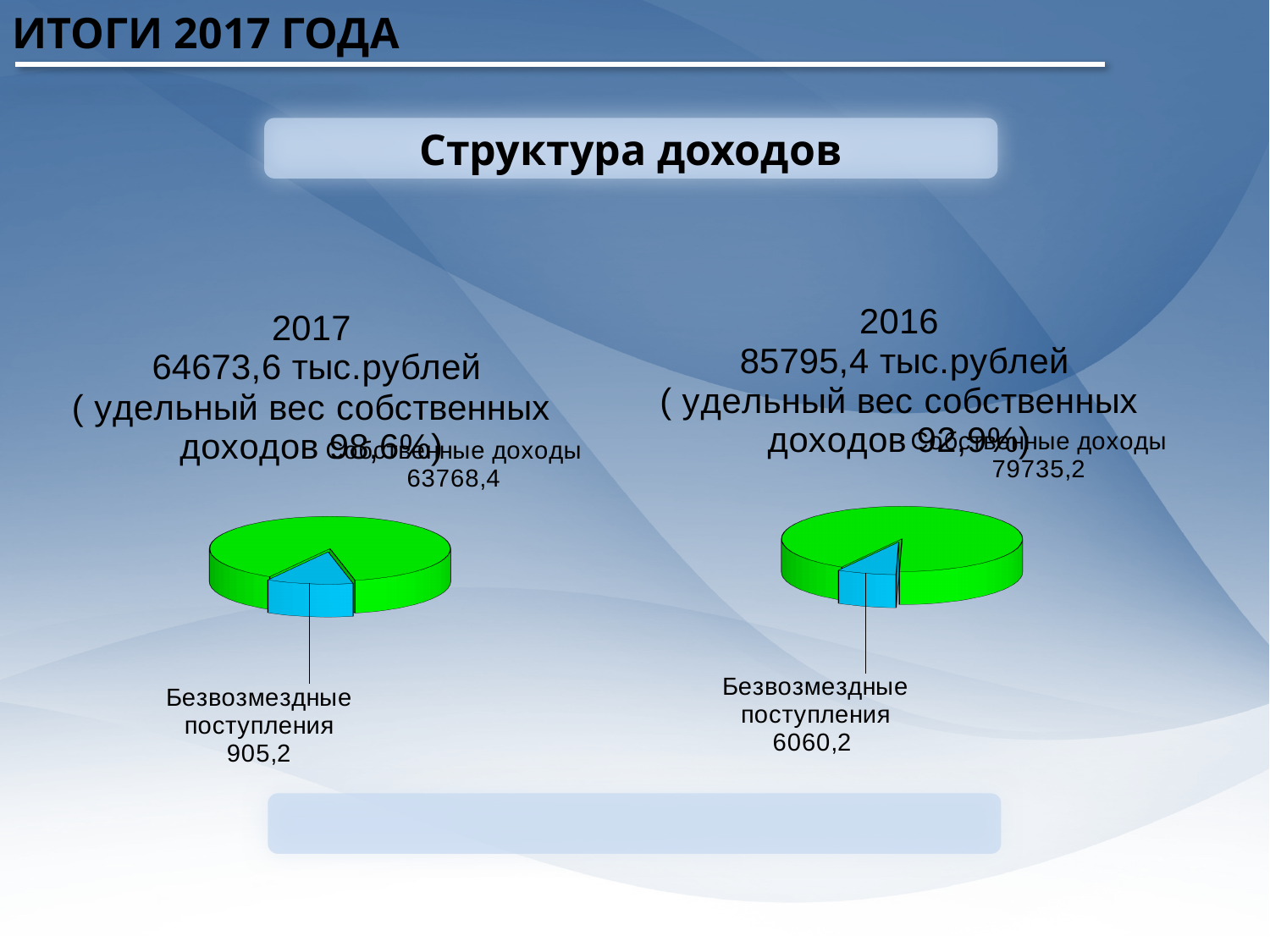
What kind of chart is used for the 2016 data on the right? Pie chart In the 2016 pie chart on the right, what is the difference between Собственные доходы and Безвозмездные поступления? 73675 In the 2017 pie chart on the left, which category has the largest slice? Собственные доходы In the 2017 pie chart on the left, what is the value for Собственные доходы? 63768,4 In the 2016 pie chart on the right, what is the value for Собственные доходы? 79735,2 In the 2017 pie chart on the left, what is the difference between Собственные доходы and Безвозмездные поступления? 62863,2 In the 2016 pie chart on the right, what is the value for Безвозмездные поступления? 6060,2 In the 2016 pie chart on the right, which category has the smallest slice? Безвозмездные поступления In the 2017 pie chart on the left, what is the value for Безвозмездные поступления? 905,2 How many slices does the 2017 pie chart on the left have? 2 Which is larger: Безвозмездные поступления in the 2017 chart on the left or in the 2016 chart on the right? 2016 chart (6060,2) In the 2016 pie chart on the right, what is the total of Собственные доходы and Безвозмездные поступления? 85795,4